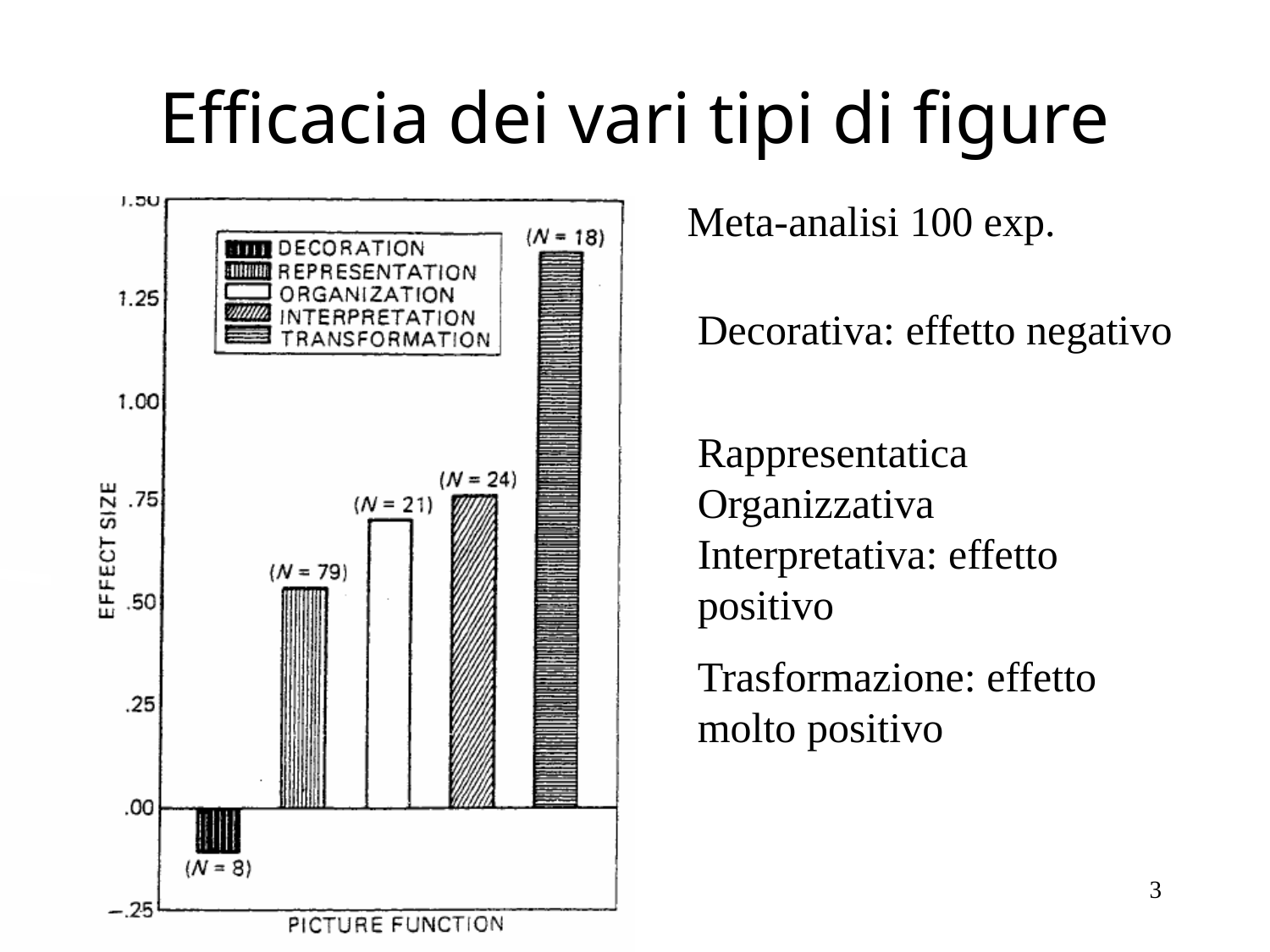
How many entries does the chart's legend list? 5 What is the label of the y axis? EFFECT SIZE Is the effect size for Decoration greater or less than .00? less Is the effect size for Transformation greater or less than 1.25? greater What is the N value shown above the Representation bar? N = 79 Which picture function has the lowest effect size? Decoration How many bars (picture functions) are plotted in the chart? 5 What is the N value shown for the Decoration bar? N = 8 Which picture function has the highest effect size? Transformation Which has a larger effect size, Representation or Organization? Organization What kind of chart is shown on the slide? bar chart What is the N value shown for the Transformation bar? N = 18